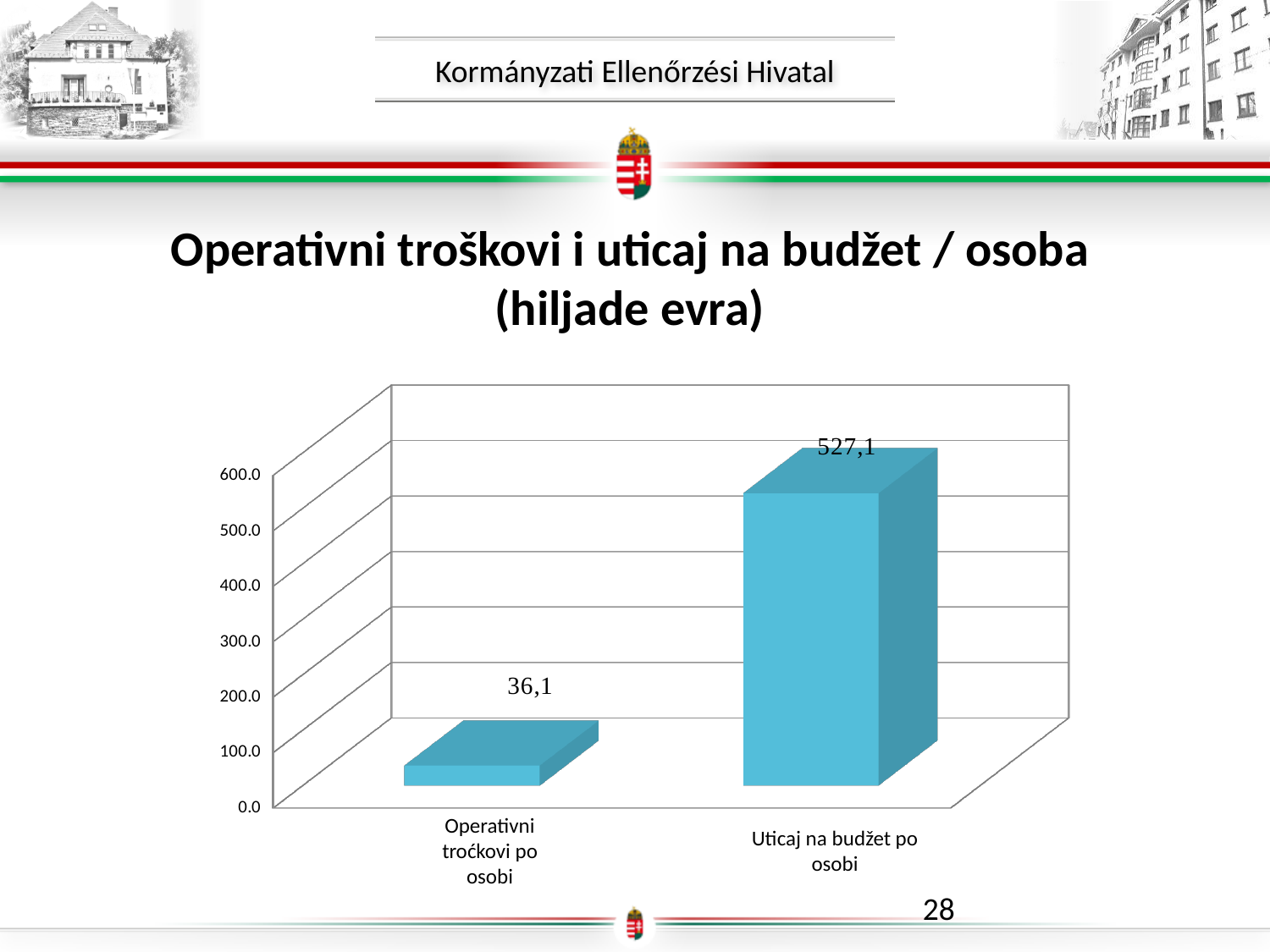
Which category has the highest value? Uticaj na budžet po osobi Is the value for Operativni troćkovi po osobi greater or less than 100.0? less What is the value for Uticaj na budžet po osobi? 527,1 What kind of chart is shown on the slide? bar chart What is the value for Operativni troćkovi po osobi? 36,1 Which is larger: the value for Operativni troćkovi po osobi or the value for Uticaj na budžet po osobi? Uticaj na budžet po osobi What is the title of the slide above the chart? Operativni troškovi i uticaj na budžet / osoba (hiljade evra) What is the difference between the value for Uticaj na budžet po osobi and the value for Operativni troćkovi po osobi? 491,0 Which category has the lowest value? Operativni troćkovi po osobi What is the highest value labelled on the vertical axis? 600.0 How many categories are shown in the chart? 2 Is the value for Uticaj na budžet po osobi greater or less than 400.0? greater